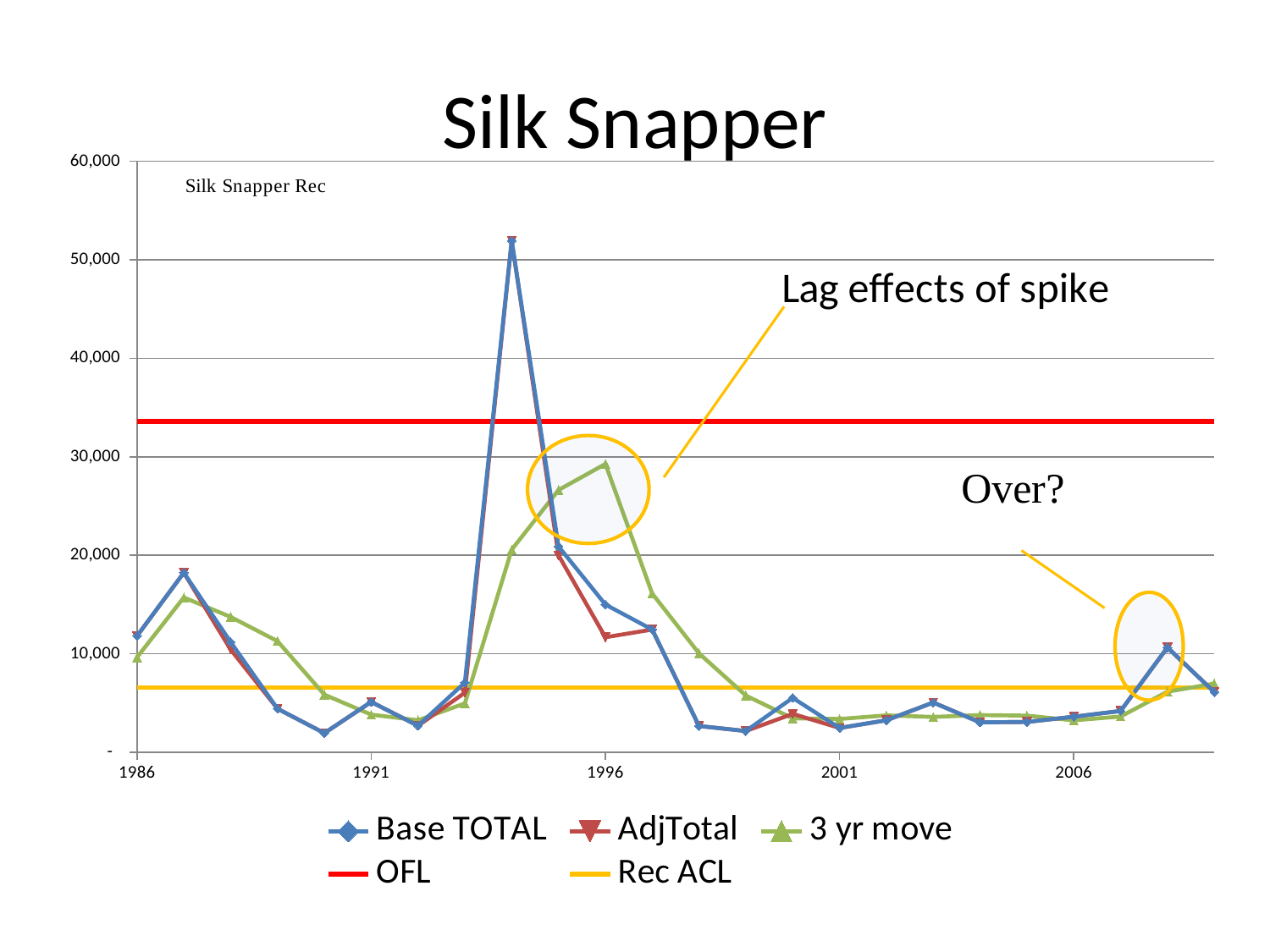
Which series is drawn as the red horizontal line? OFL Is the OFL line greater or less than 30,000? greater Is the peak value of Base TOTAL in 1994 greater or less than 50,000? greater Is the Base TOTAL value in 2001 greater or less than 10,000? less How many series does the legend list? 5 In which year does the Base TOTAL series reach its highest value? 1994 Does the Base TOTAL series rise or fall from 1994 to 1996? fall What is the title of the slide? Silk Snapper Which horizontal line is higher, OFL or Rec ACL? OFL What kind of chart is shown on the slide? line chart